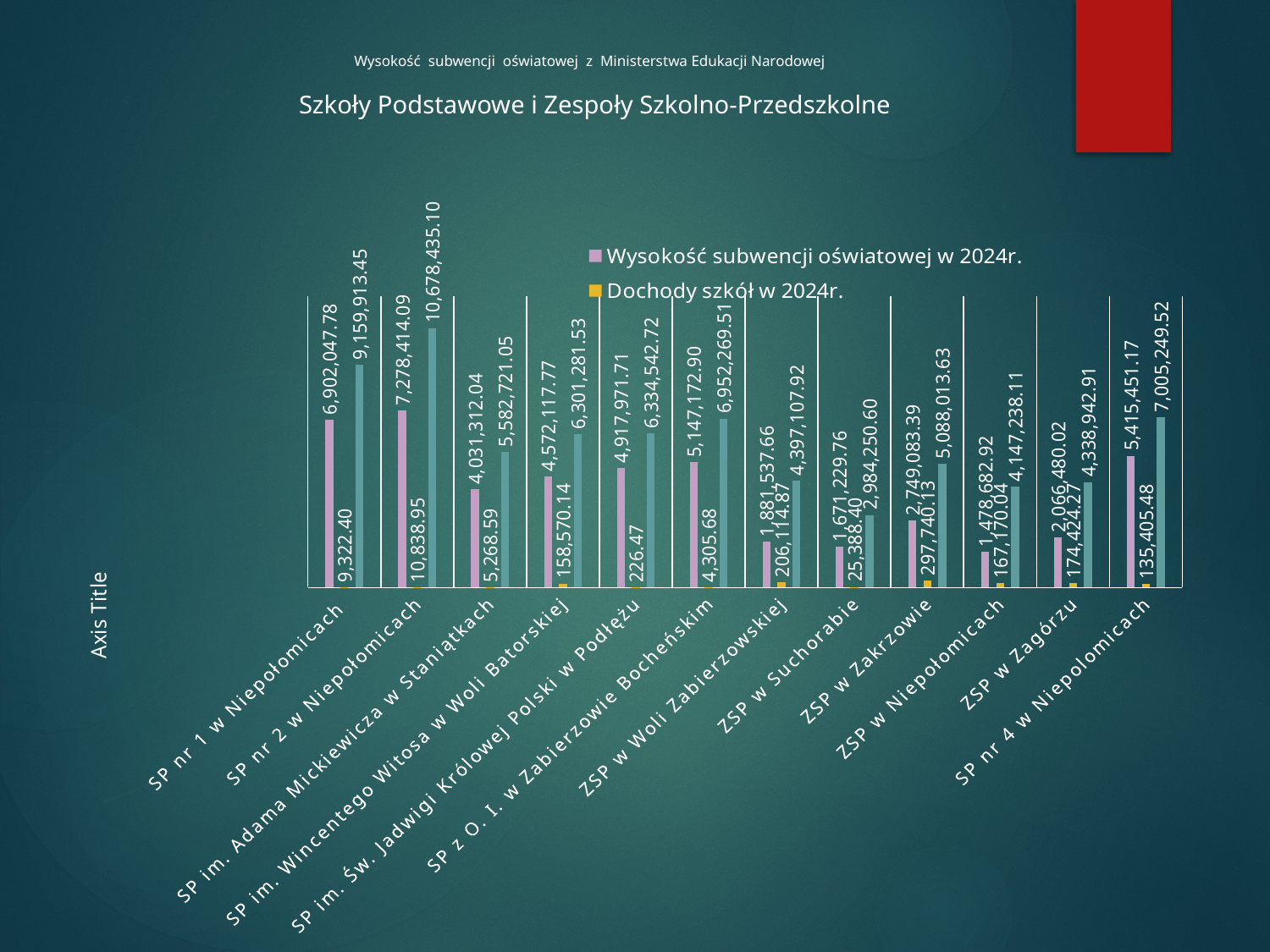
What is the value of 'Dochody szkół w 2024r.' for ZSP w Zakrzowie? 297,740.13 How many series does the chart legend list? 2 What is the difference in 'Wysokość subwencji oświatowej w 2024r.' between SP nr 2 w Niepołomicach and SP nr 1 w Niepołomicach? 376,366.31 What kind of chart is shown on the slide? Bar chart What is the title of the chart? Szkoły Podstawowe i Zespoły Szkolno-Przedszkolne Which school has the highest value of 'Dochody szkół w 2024r.'? ZSP w Zakrzowie Which school has the lowest value of 'Wysokość subwencji oświatowej w 2024r.'? ZSP w Niepołomicach Which has a larger 'Wysokość subwencji oświatowej w 2024r.': SP nr 4 w Niepołomicach or SP z O. I. w Zabierzowie Bocheńskim? SP nr 4 w Niepołomicach Which school has the highest value of 'Wysokość subwencji oświatowej w 2024r.'? SP nr 2 w Niepołomicach What is the value of 'Dochody szkół w 2024r.' for SP im. Św. Jadwigi Królowej Polski w Podłężu? 226.47 What is the value of 'Wysokość subwencji oświatowej w 2024r.' for SP nr 1 w Niepołomicach? 6,902,047.78 How many schools are shown on the x axis of the chart? 12